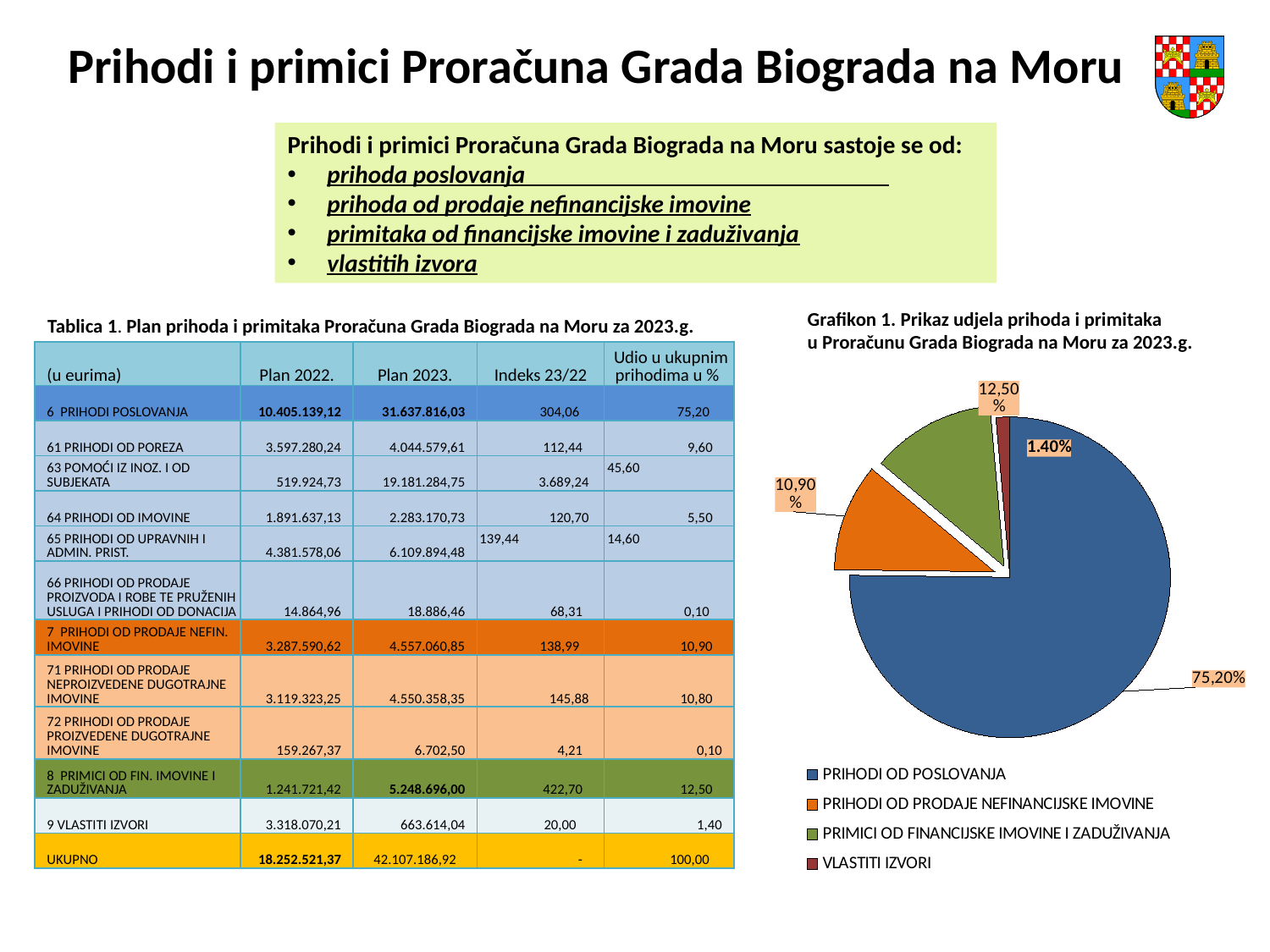
What is the difference in percentage points between the PRIHODI OD POSLOVANJA slice and the PRIMICI OD FINANCIJSKE IMOVINE I ZADUŽIVANJA slice? 62,70 What is the title of the chart on the slide? Grafikon 1. Prikaz udjela prihoda i primitaka u Proračunu Grada Biograda na Moru za 2023.g. What share of the pie chart does PRIMICI OD FINANCIJSKE IMOVINE I ZADUŽIVANJA represent? 12,50% Which category has the largest slice in the pie chart? PRIHODI OD POSLOVANJA Which slice is larger: PRIMICI OD FINANCIJSKE IMOVINE I ZADUŽIVANJA or PRIHODI OD PRODAJE NEFINANCIJSKE IMOVINE? PRIMICI OD FINANCIJSKE IMOVINE I ZADUŽIVANJA What share of the pie chart does PRIHODI OD PRODAJE NEFINANCIJSKE IMOVINE represent? 10,90% How many slices does the pie chart have? 4 Which category has the smallest slice in the pie chart? VLASTITI IZVORI How many entries does the legend of the pie chart list? 4 What type of chart is shown on the slide? Pie chart What share of the pie chart does PRIHODI OD POSLOVANJA represent? 75,20% What share of the pie chart does VLASTITI IZVORI represent? 1.40%